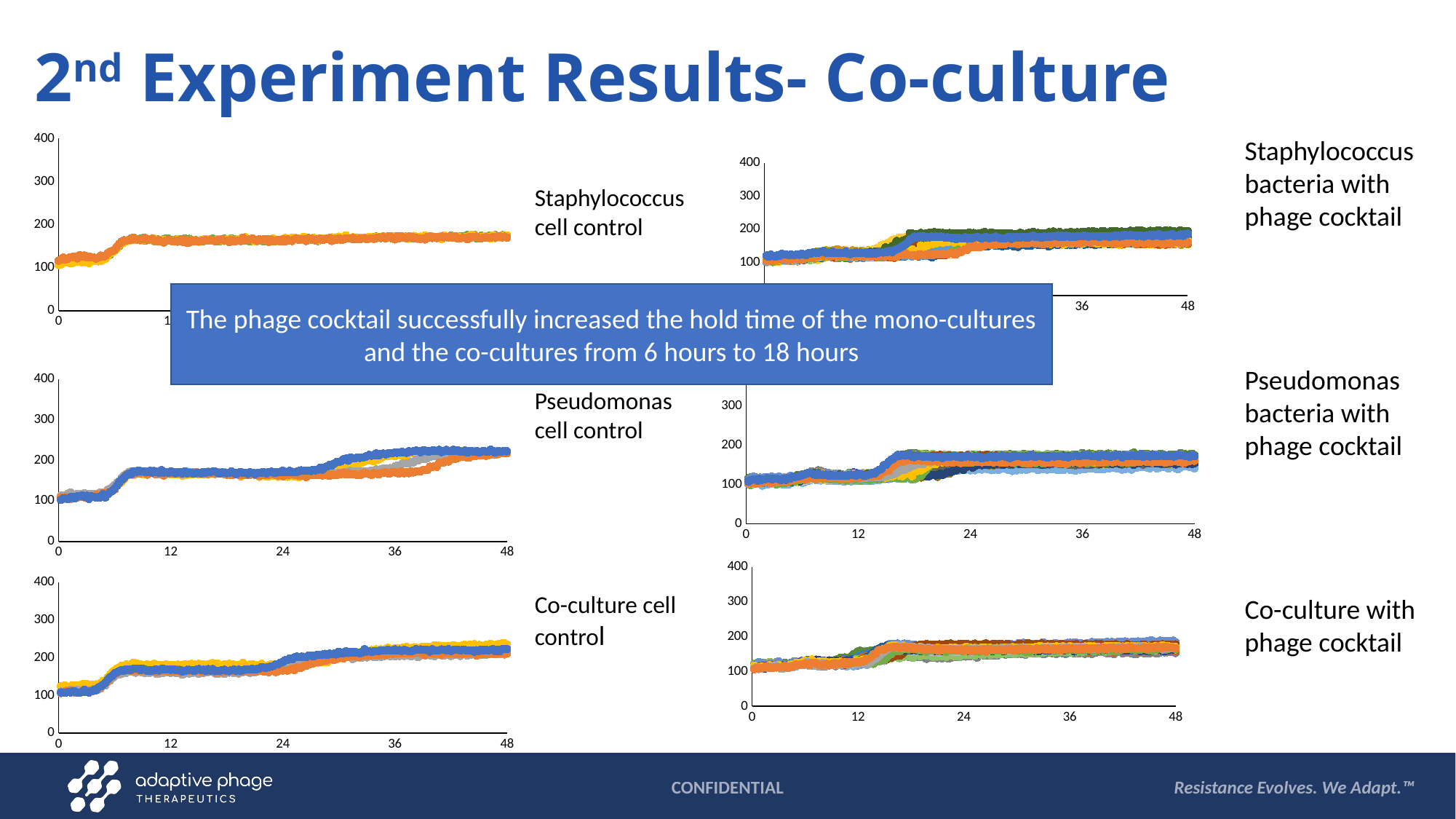
In the 'Pseudomonas bacteria with phage cocktail' chart, is the value at 48 hours greater or less than 200? less In the 'Co-culture with phage cocktail' chart, is the value at 48 hours greater or less than 300? less At 48 hours, which chart shows the larger value: 'Pseudomonas cell control' or 'Staphylococcus cell control'? Pseudomonas cell control In the 'Staphylococcus bacteria with phage cocktail' chart, is the value at 0 hours greater or less than 200? less How many charts are shown on the slide? 6 In the 'Staphylococcus cell control' chart, do the values rise or fall from 0 to 48 hours? rise In the 'Pseudomonas cell control' chart, do the values rise or fall from 0 to 48 hours? rise What is the highest value shown on the y axis of the 'Co-culture cell control' chart? 400 What kind of chart is the 'Staphylococcus cell control' chart? line chart